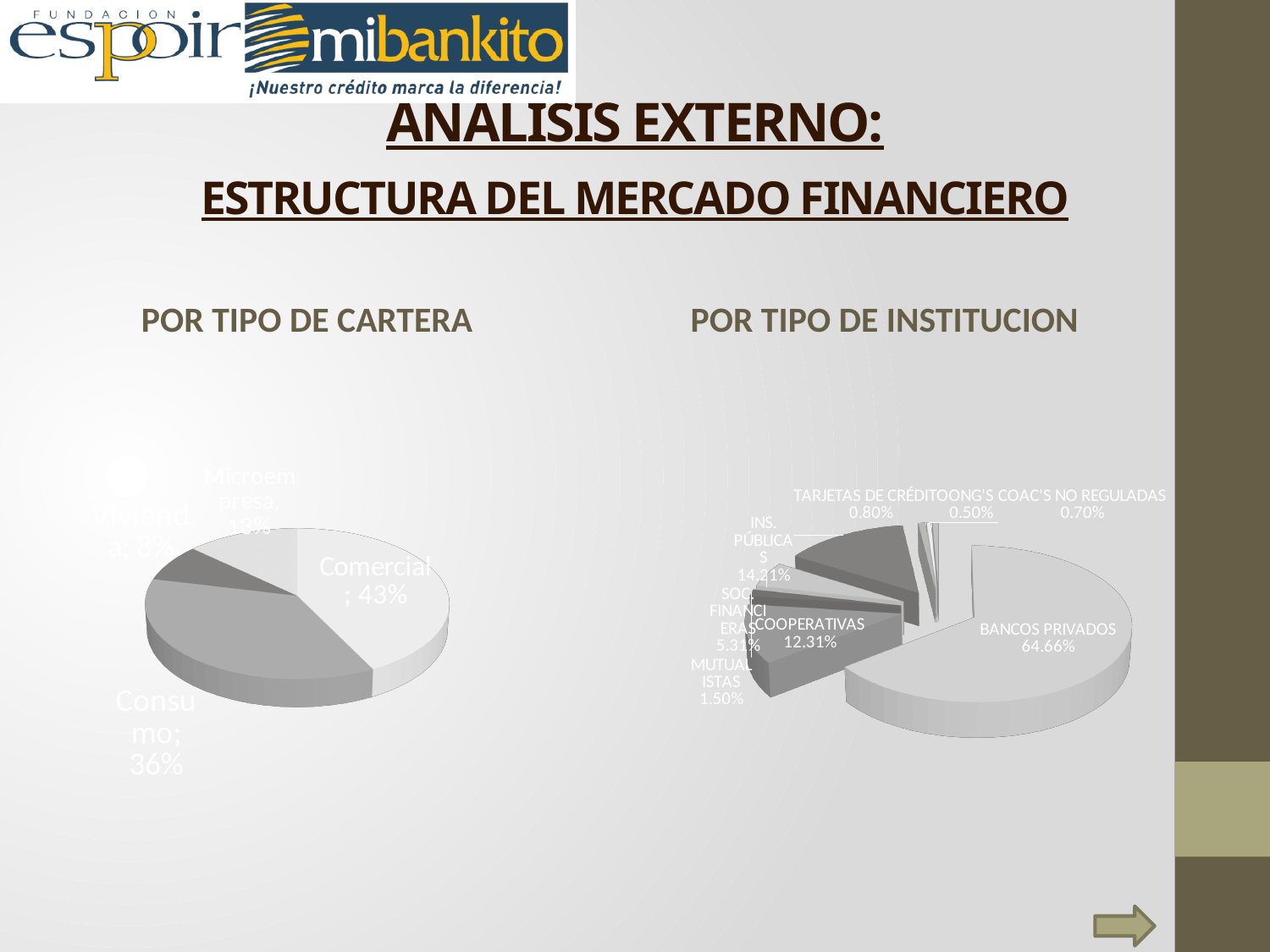
In the 'POR TIPO DE INSTITUCION' chart, what share do Mutualistas have? 1.50% In the 'POR TIPO DE CARTERA' chart, which category has the largest share? Comercial In the 'POR TIPO DE CARTERA' chart, what is the difference between the Comercial and Consumo shares? 7% In the 'POR TIPO DE CARTERA' chart, how many slices does the pie have? 4 In the 'POR TIPO DE CARTERA' chart, what share does Consumo have? 36% In the 'POR TIPO DE INSTITUCION' chart, which category has the smallest share? ONG'S In the 'POR TIPO DE INSTITUCION' chart, which is larger, Ins. Públicas or Cooperativas? Ins. Públicas In the 'POR TIPO DE CARTERA' chart, which category has the smallest share? Vivienda In the 'POR TIPO DE INSTITUCION' chart, what share do Cooperativas have? 12.31% In the 'POR TIPO DE INSTITUCION' chart, what share do Bancos Privados have? 64.66% In the 'POR TIPO DE CARTERA' chart, what share does Comercial have? 43% What type of chart is used for 'POR TIPO DE INSTITUCION'? Pie chart